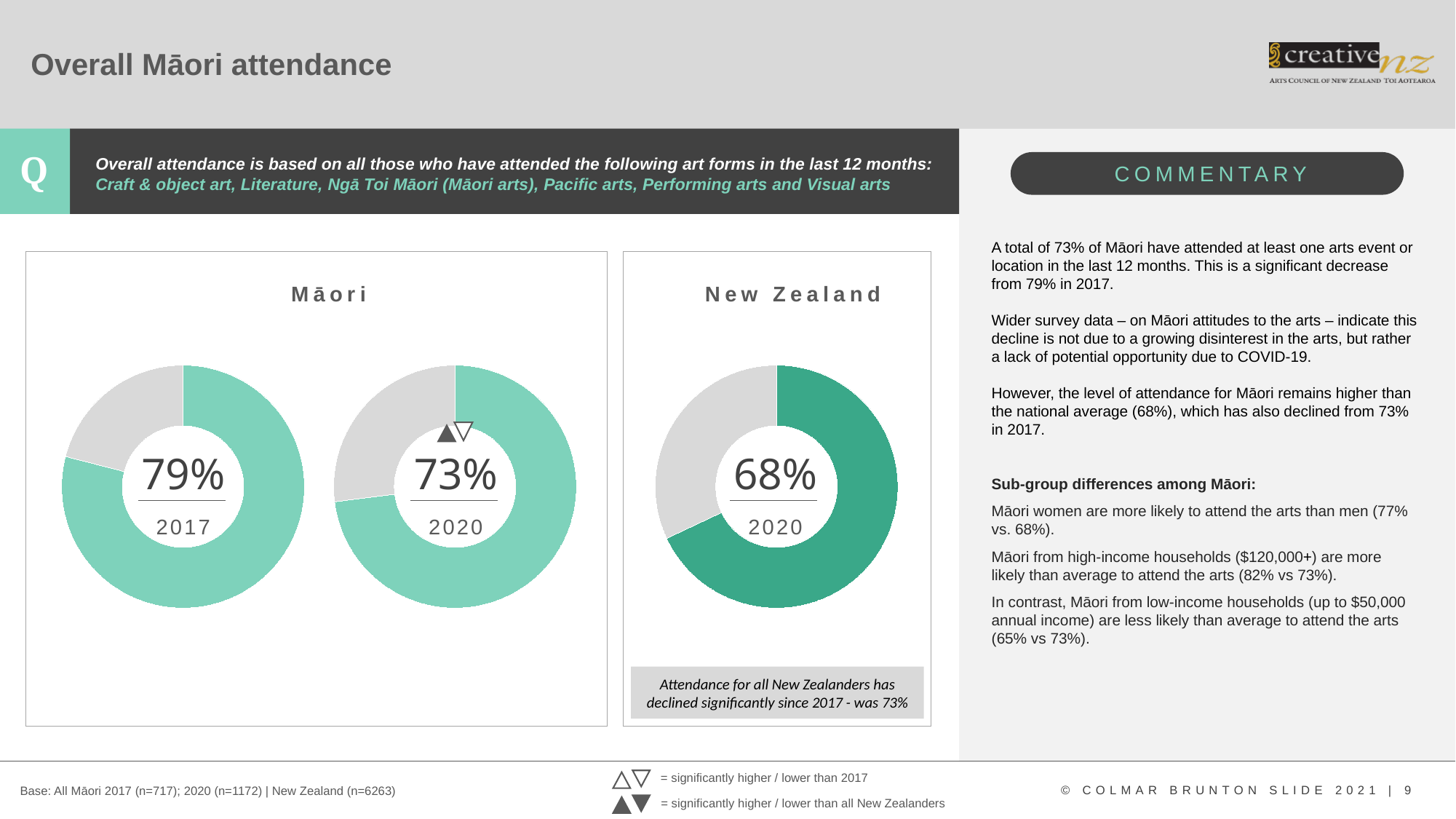
In the Māori panel, by how many percentage points did attendance fall from 2017 to 2020? 6 percentage points What is the title of the panel containing the 68% donut chart? New Zealand In the Māori panel, what is the attendance value shown in the 2020 donut chart? 73% Across the three donut charts on the slide, which one shows the lowest value? New Zealand 2020 (68%) Which is larger: the Māori 2020 attendance or the New Zealand 2020 attendance? Māori 2020 How many donut charts are shown in the Māori panel? 2 Across the three donut charts on the slide, which one shows the highest value? Māori 2017 (79%) What is the difference between the Māori 2020 value and the New Zealand 2020 value? 5 percentage points What type of chart is used to display the attendance figures on this slide? Donut (pie) chart In the Māori panel, does attendance rise or fall from 2017 to 2020? Fall In the New Zealand panel, what is the attendance value shown in the 2020 donut chart? 68% In the Māori panel, what is the attendance value shown in the 2017 donut chart? 79%